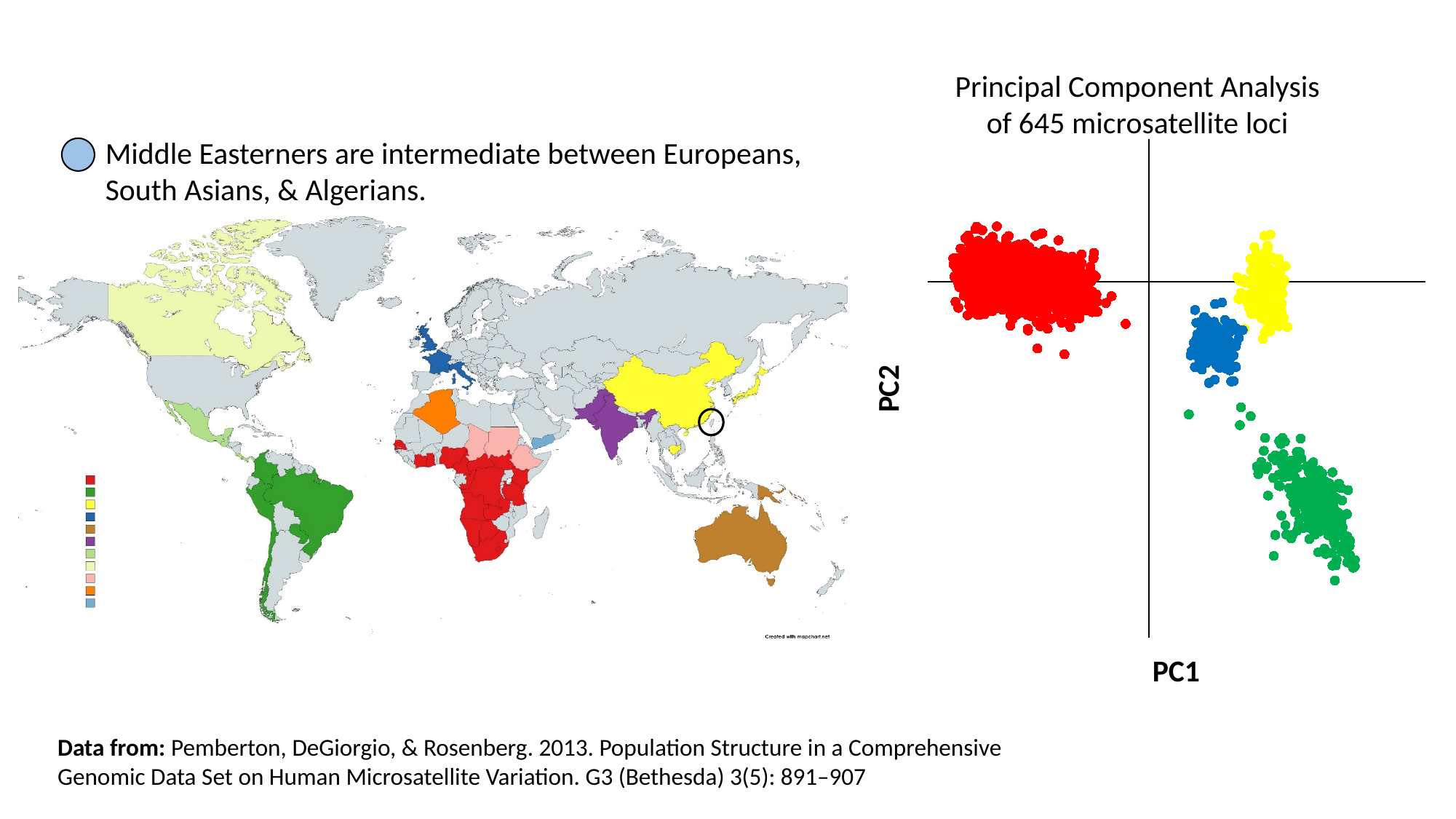
In the Principal Component Analysis chart, which coloured cluster lies lowest along PC2? green In the Principal Component Analysis chart, which cluster contains more points, the red cluster or the blue cluster? red What are the labels of the horizontal and vertical axes of the Principal Component Analysis chart? PC1 and PC2 In the Principal Component Analysis chart, is the green cluster above or below the horizontal axis line? below What is the title of the chart on the right of the slide? Principal Component Analysis of 645 microsatellite loci How many distinct coloured clusters of points are shown in the Principal Component Analysis chart? 4 In the Principal Component Analysis chart, is the blue cluster above or below the horizontal axis line? below What kind of chart is the Principal Component Analysis chart on the right of the slide? scatter plot In the Principal Component Analysis chart, which coloured cluster lies furthest to the right along PC1? green In the Principal Component Analysis chart, which coloured cluster lies furthest to the left along PC1? red